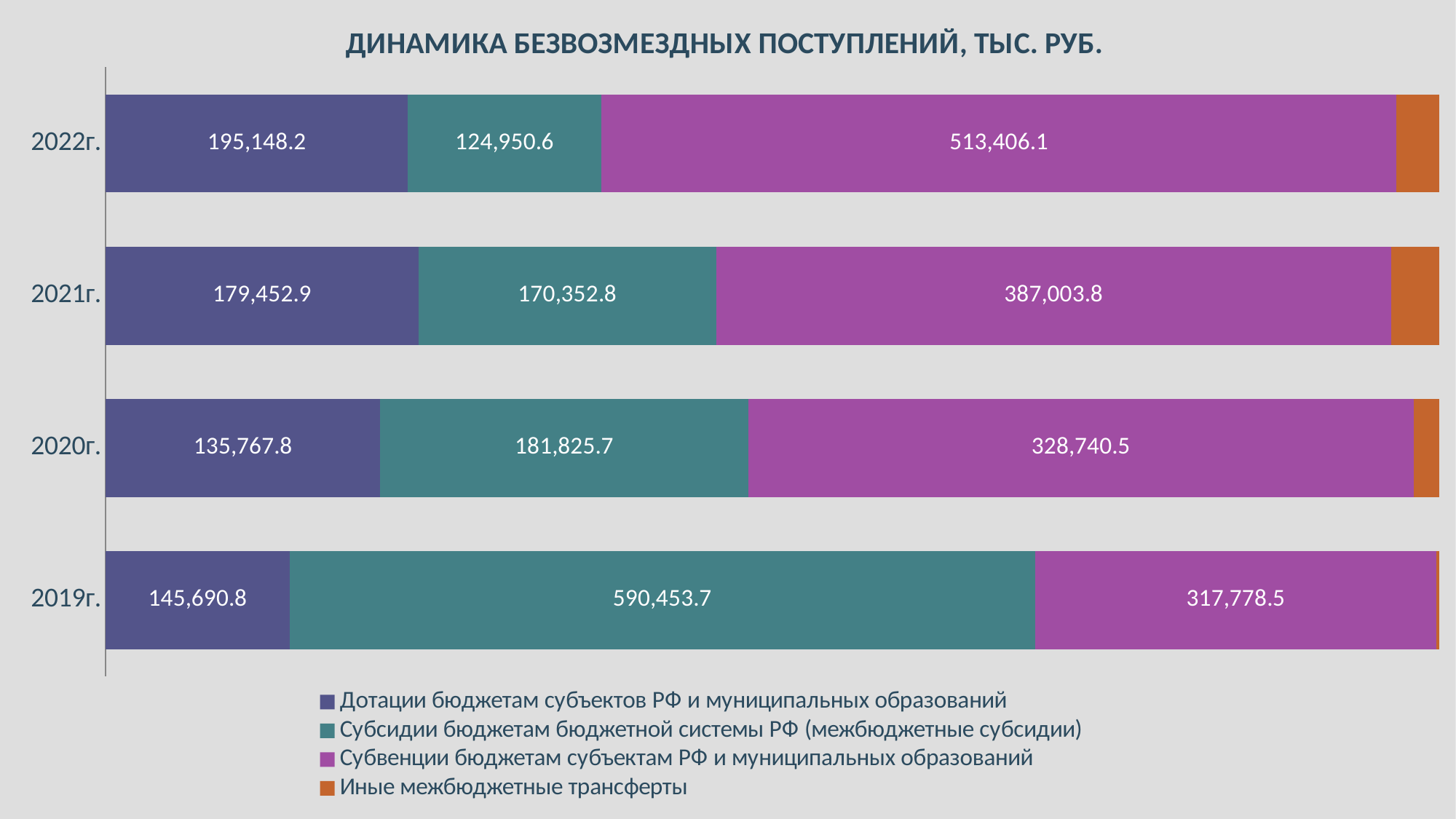
How many series does the legend list? 4 What is the difference between the Субвенции values for 2022г. and 2021г.? 126,402.3 What is the value of Субвенции бюджетам субъектам РФ и муниципальных образований for 2021г.? 387,003.8 Do the values of Субвенции бюджетам субъектам РФ и муниципальных образований rise or fall from 2020г. to 2022г.? Rise In which year is the value of Субвенции бюджетам субъектам РФ и муниципальных образований the highest? 2022г. What kind of chart is shown on the slide? Stacked bar chart Which year has the larger value of Субсидии бюджетам бюджетной системы РФ: 2020г. or 2021г.? 2020г. What is the value of Субсидии бюджетам бюджетной системы РФ (межбюджетные субсидии) for 2019г.? 590,453.7 In which year is the value of Дотации бюджетам субъектов РФ и муниципальных образований the lowest? 2020г. What is the value of Дотации бюджетам субъектов РФ и муниципальных образований for 2022г.? 195,148.2 How many years are shown on the chart? 4 By how much did Дотации бюджетам субъектов РФ и муниципальных образований increase from 2021г. to 2022г.? 15,695.3